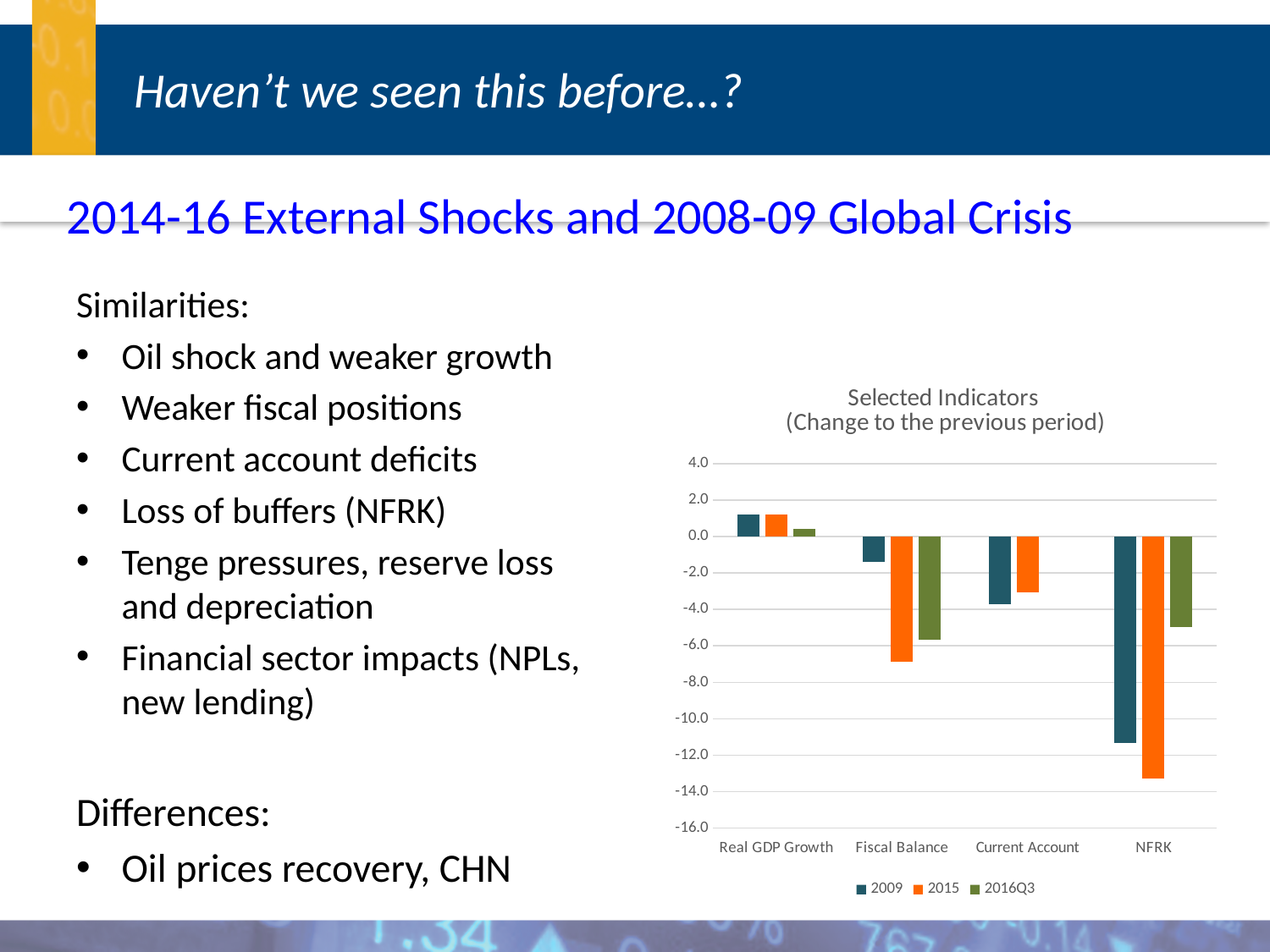
Is the 2009 value for Real GDP Growth greater or less than 0.0? greater Which category has the highest values in the chart? Real GDP Growth What is the title of the chart? Selected Indicators (Change to the previous period) How many categories are shown on the x axis of the chart? 4 For NFRK, which series has the lower value, 2009 or 2015? 2015 Is the 2015 value for NFRK greater or less than -12.0? less Which series are listed in the chart's legend? 2009, 2015, 2016Q3 Which category has the lowest value in the chart? NFRK Is the 2015 value for Fiscal Balance greater or less than -6.0? less How many series does the chart's legend list? 3 What kind of chart is shown on the slide? bar chart